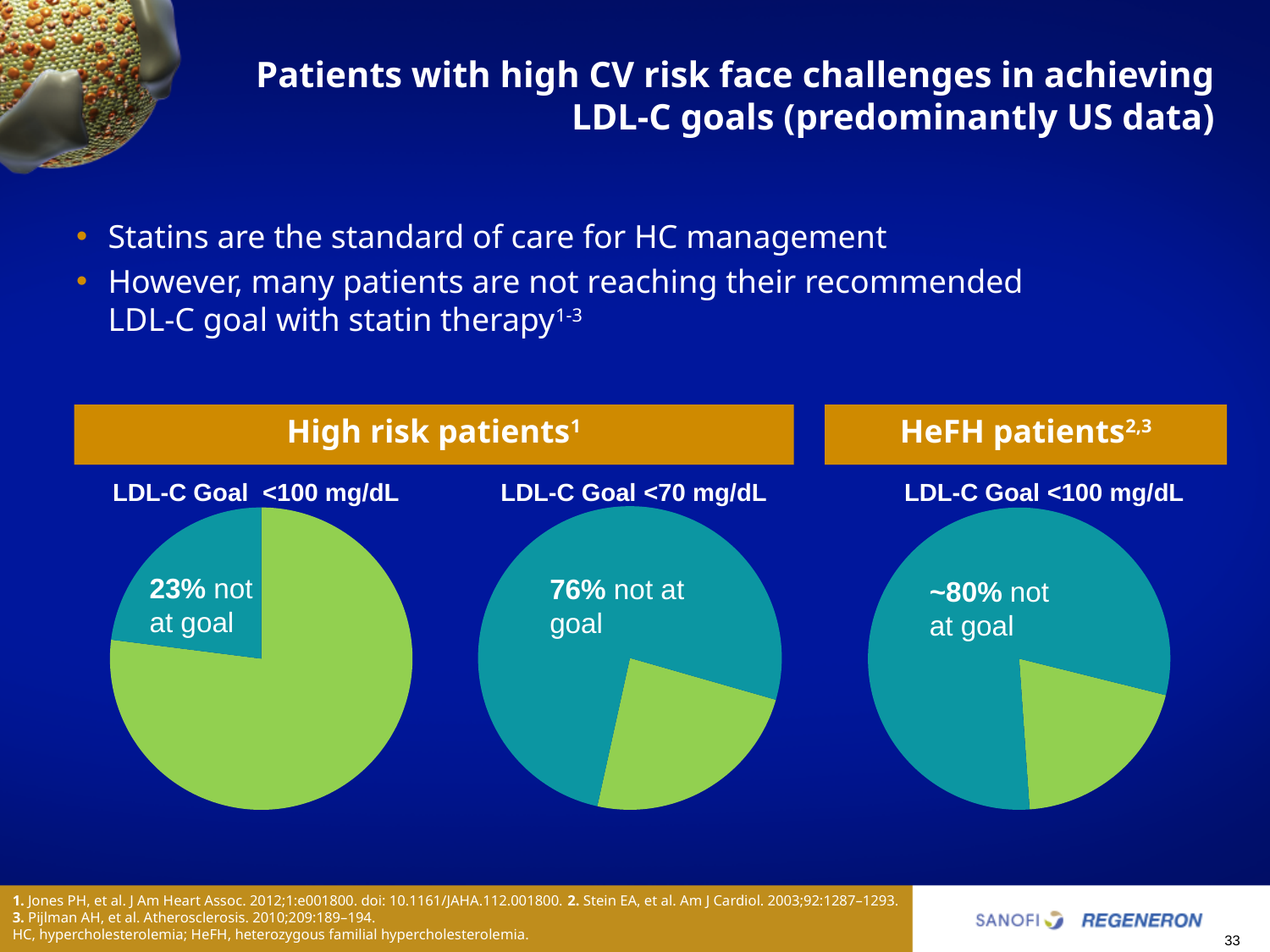
In the High risk patients chart with LDL-C Goal <100 mg/dL, what percentage of patients are not at goal? 23% How many pie charts are on the slide? 3 In the High risk patients chart with LDL-C Goal <70 mg/dL, what share of the pie represents patients at goal? 24% What is the difference in percentage points between the not-at-goal share for the <70 mg/dL goal and the <100 mg/dL goal in the High risk patients charts? 53 percentage points Of the three pie charts, which has the smallest share of patients not at goal? High risk patients, LDL-C Goal <100 mg/dL In the High risk patients chart with LDL-C Goal <70 mg/dL, what percentage of patients are not at goal? 76% What kind of charts are shown on the slide? Pie charts In the High risk patients chart with LDL-C Goal <100 mg/dL, what share of the pie represents patients at goal? 77% Among the two High risk patients charts, which LDL-C goal has the larger share of patients not at goal? LDL-C Goal <70 mg/dL In the High risk patients chart with LDL-C Goal <70 mg/dL, does the not-at-goal slice cover more or less than half of the pie? More In the HeFH patients chart (LDL-C Goal <100 mg/dL), what percentage of patients are not at goal? ~80% What is the heading above the two left-hand pie charts? High risk patients